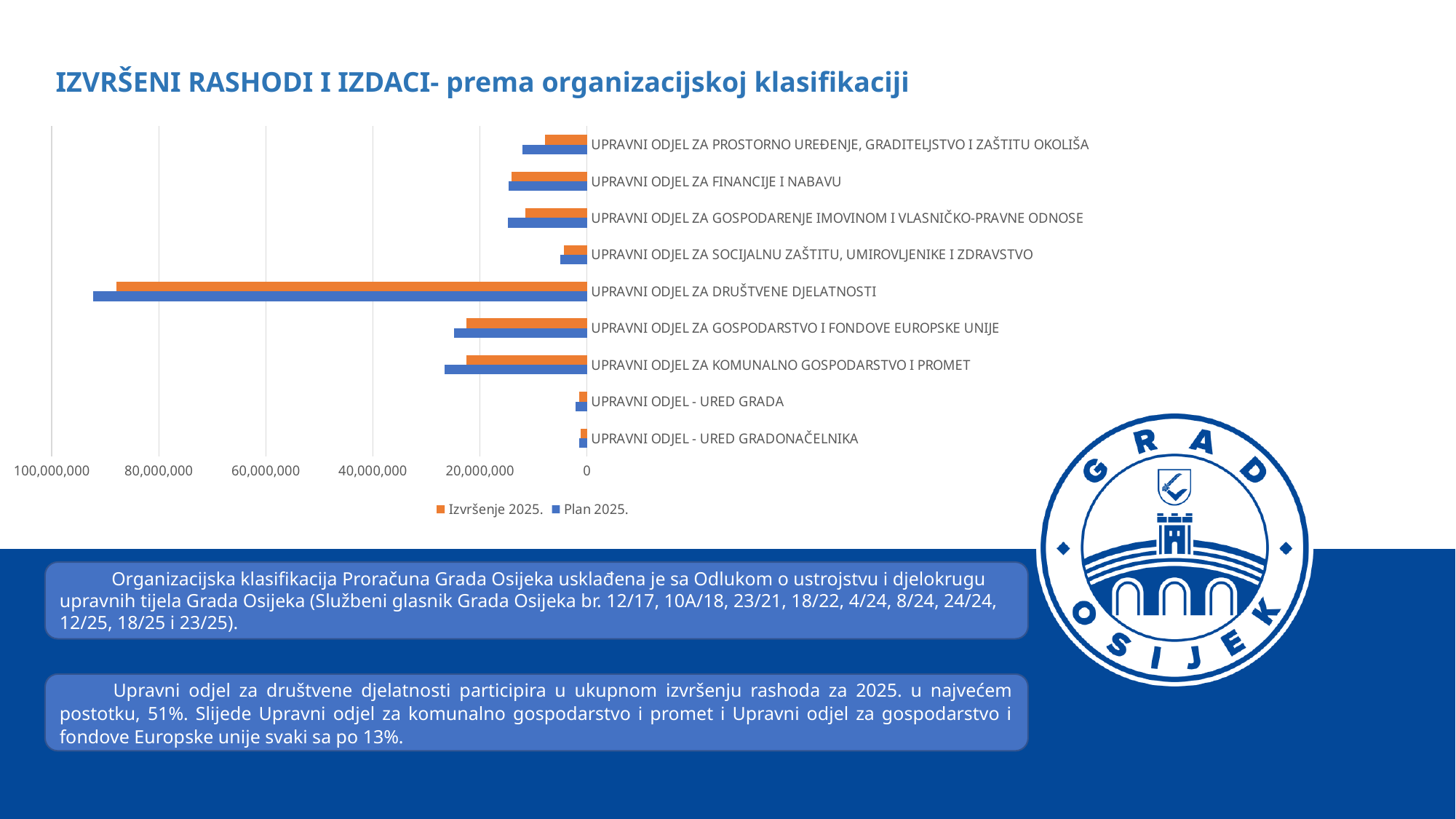
Which colour represents the Izvršenje 2025. series in the chart? Orange What kind of chart is shown on the slide? Bar chart How many series does the legend list? 2 Is the Plan 2025. value for UPRAVNI ODJEL ZA KOMUNALNO GOSPODARSTVO I PROMET greater or less than 20,000,000? greater For UPRAVNI ODJEL ZA PROSTORNO UREĐENJE, GRADITELJSTVO I ZAŠTITU OKOLIŠA, which is larger: Plan 2025. or Izvršenje 2025.? Plan 2025. Is the Plan 2025. value for UPRAVNI ODJEL ZA SOCIJALNU ZAŠTITU, UMIROVLJENIKE I ZDRAVSTVO greater or less than 20,000,000? less Which category has the highest Plan 2025. value? UPRAVNI ODJEL ZA DRUŠTVENE DJELATNOSTI Is the Izvršenje 2025. value for UPRAVNI ODJEL ZA DRUŠTVENE DJELATNOSTI greater or less than 80,000,000? greater How many categories (upravni odjeli) are shown on the chart? 9 For UPRAVNI ODJEL ZA DRUŠTVENE DJELATNOSTI, which is larger: Plan 2025. or Izvršenje 2025.? Plan 2025. Which category has the highest Izvršenje 2025. value? UPRAVNI ODJEL ZA DRUŠTVENE DJELATNOSTI